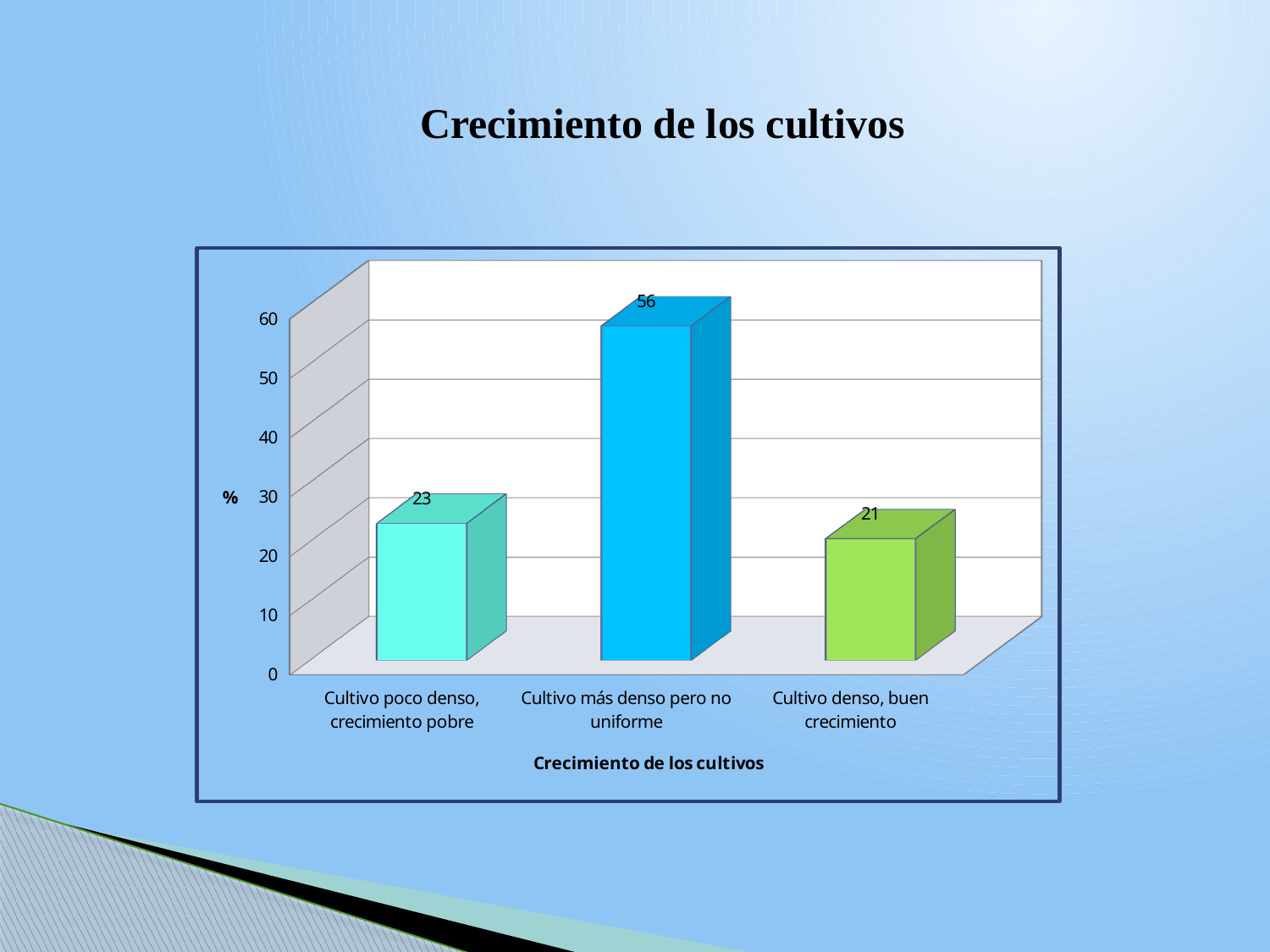
Which is larger: the value for "Cultivo más denso pero no uniforme" or for "Cultivo denso, buen crecimiento"? Cultivo más denso pero no uniforme What is the value for "Cultivo poco denso, crecimiento pobre"? 23 Is the value for "Cultivo más denso pero no uniforme" greater or less than 50? greater How many categories are shown on the x axis? 3 Which category has the highest value? Cultivo más denso pero no uniforme What is the label on the vertical axis of the chart? % What is the difference between the values for "Cultivo más denso pero no uniforme" and "Cultivo poco denso, crecimiento pobre"? 33 What is the value for "Cultivo más denso pero no uniforme"? 56 What kind of chart is shown on the slide? bar chart What is the difference between the values for "Cultivo poco denso, crecimiento pobre" and "Cultivo denso, buen crecimiento"? 2 Which category has the lowest value? Cultivo denso, buen crecimiento What is the value for "Cultivo denso, buen crecimiento"? 21